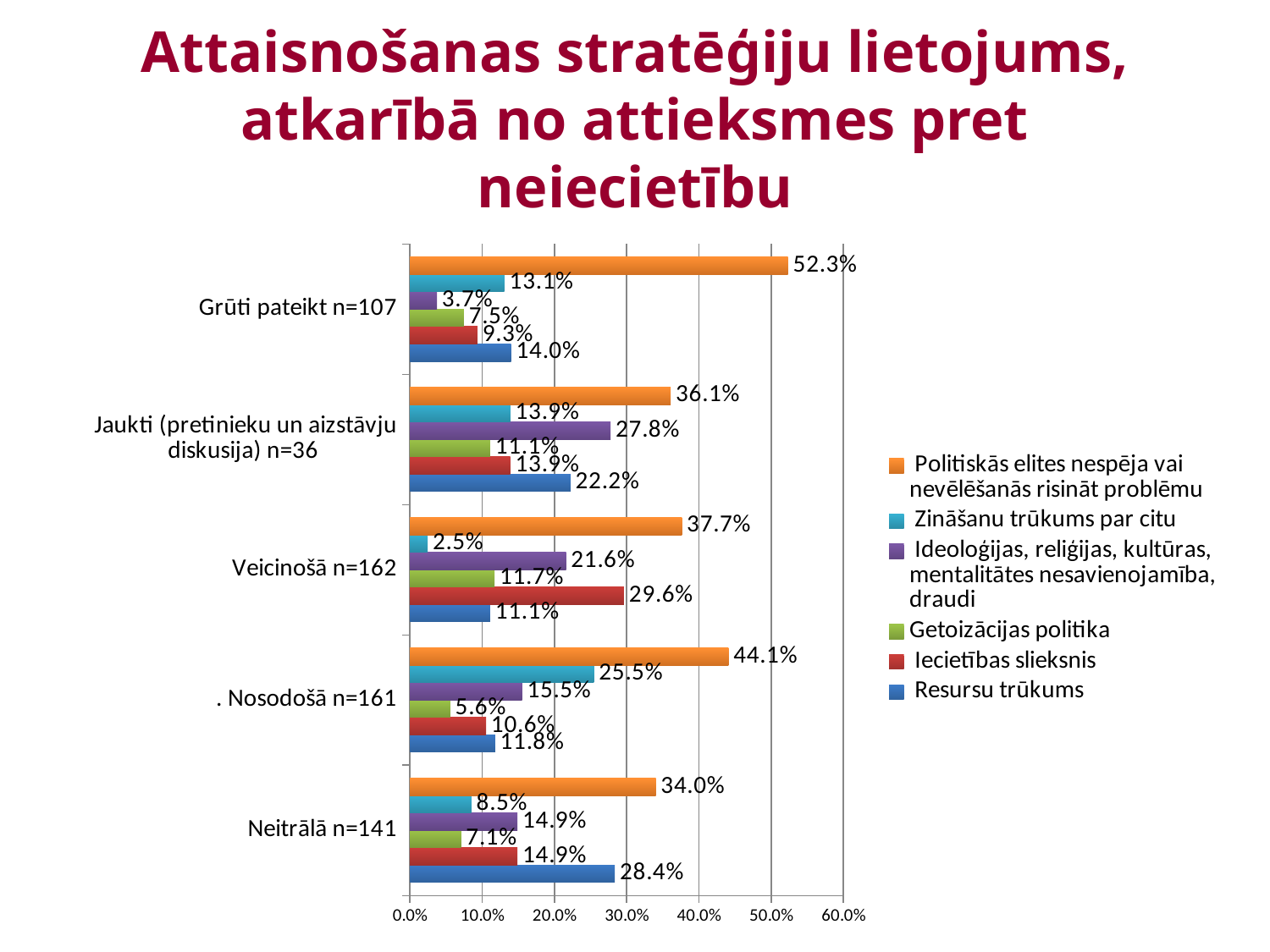
What is the value for "Zināšanu trūkums par citu" in the "Nosodošā n=161" category? 25.5% What is the value for "Resursu trūkums" in the "Neitrālā n=141" category? 28.4% Is the value for "Politiskās elites nespēja vai nevēlēšanās risināt problēmu" in the "Veicinošā n=162" category greater or less than 30%? greater What is the difference between the "Politiskās elites nespēja vai nevēlēšanās risināt problēmu" values for "Nosodošā n=161" and "Neitrālā n=141"? 10.1% Which category has the highest value for "Politiskās elites nespēja vai nevēlēšanās risināt problēmu"? Grūti pateikt n=107 What is the value for "Iecietības slieksnis" in the "Veicinošā n=162" category? 29.6% What is the value for "Politiskās elites nespēja vai nevēlēšanās risināt problēmu" in the "Grūti pateikt n=107" category? 52.3% Which category has the lowest value for "Zināšanu trūkums par citu"? Veicinošā n=162 What kind of chart is shown on the slide? bar chart How many categories are shown on the vertical axis? 5 How many series does the legend list? 6 Which is larger in the "Jaukti (pretinieku un aizstāvju diskusija) n=36" category: "Ideoloģijas, reliģijas, kultūras, mentalitātes nesavienojamība, draudi" or "Resursu trūkums"? Ideoloģijas, reliģijas, kultūras, mentalitātes nesavienojamība, draudi